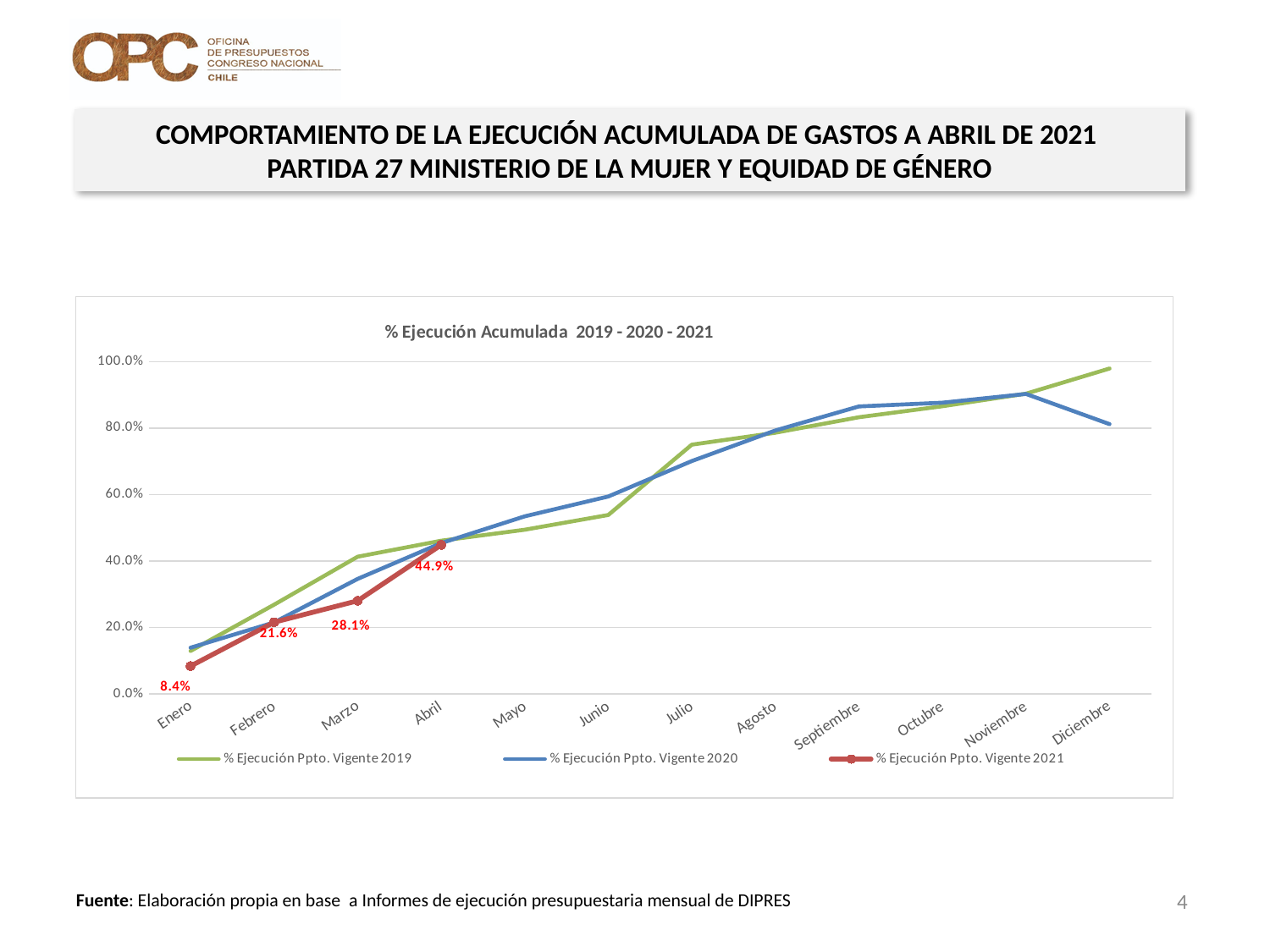
What is the value for Marzo in the % Ejecución Ppto. Vigente 2021 series? 28.1% How many series does the chart legend list? 3 What is the difference between the Febrero and Enero values of the % Ejecución Ppto. Vigente 2021 series? 13.2% How many months are shown on the x axis of the chart? 12 What is the value for Enero in the % Ejecución Ppto. Vigente 2021 series? 8.4% What type of chart is shown on the slide? Line chart What is the difference between the Abril and Marzo values of the % Ejecución Ppto. Vigente 2021 series? 16.8% What is the value for Abril in the % Ejecución Ppto. Vigente 2021 series? 44.9% Is the value for Mayo in the % Ejecución Ppto. Vigente 2020 series greater or less than 60%? less In Diciembre, which series has the larger value: % Ejecución Ppto. Vigente 2019 or % Ejecución Ppto. Vigente 2020? % Ejecución Ppto. Vigente 2019 Which month has the highest value in the % Ejecución Ppto. Vigente 2021 series? Abril Is the value for Diciembre in the % Ejecución Ppto. Vigente 2019 series greater or less than 80%? greater